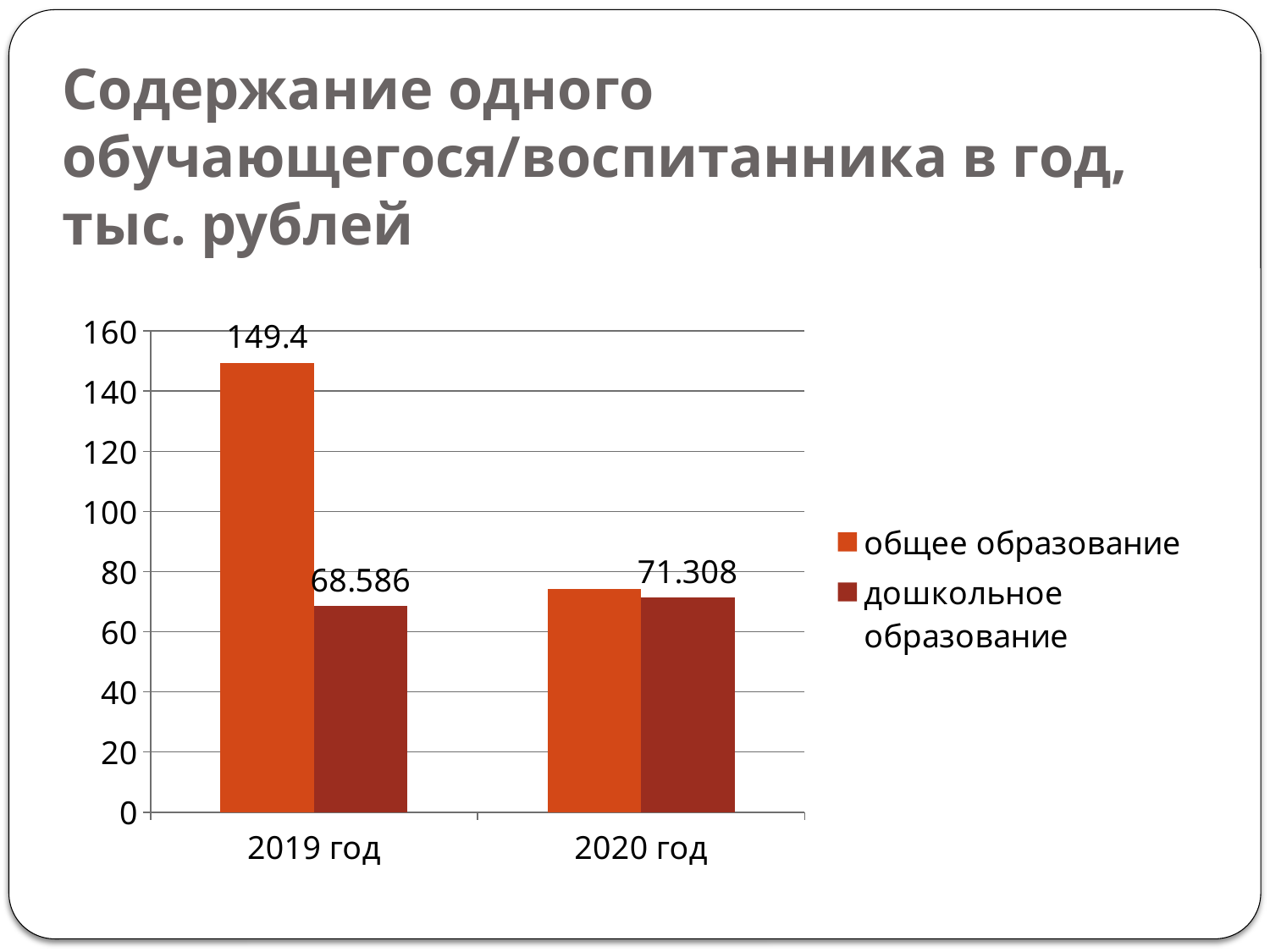
Is the value for общее образование in 2020 год greater or less than 60? greater Which is larger in 2019 год: общее образование or дошкольное образование? общее образование What is the difference between общее образование and дошкольное образование in 2019 год? 80.814 What is the value for дошкольное образование in 2020 год? 71.308 Which bar is the highest on the chart? общее образование, 2019 год Is the value for общее образование in 2020 год greater or less than 80? less What kind of chart is shown on the slide? bar chart How many series does the legend list? 2 What is the value for общее образование in 2019 год? 149.4 What is the difference between the дошкольное образование values for 2020 год and 2019 год? 2.722 Does the value for общее образование rise or fall from 2019 год to 2020 год? fall What is the value for дошкольное образование in 2019 год? 68.586